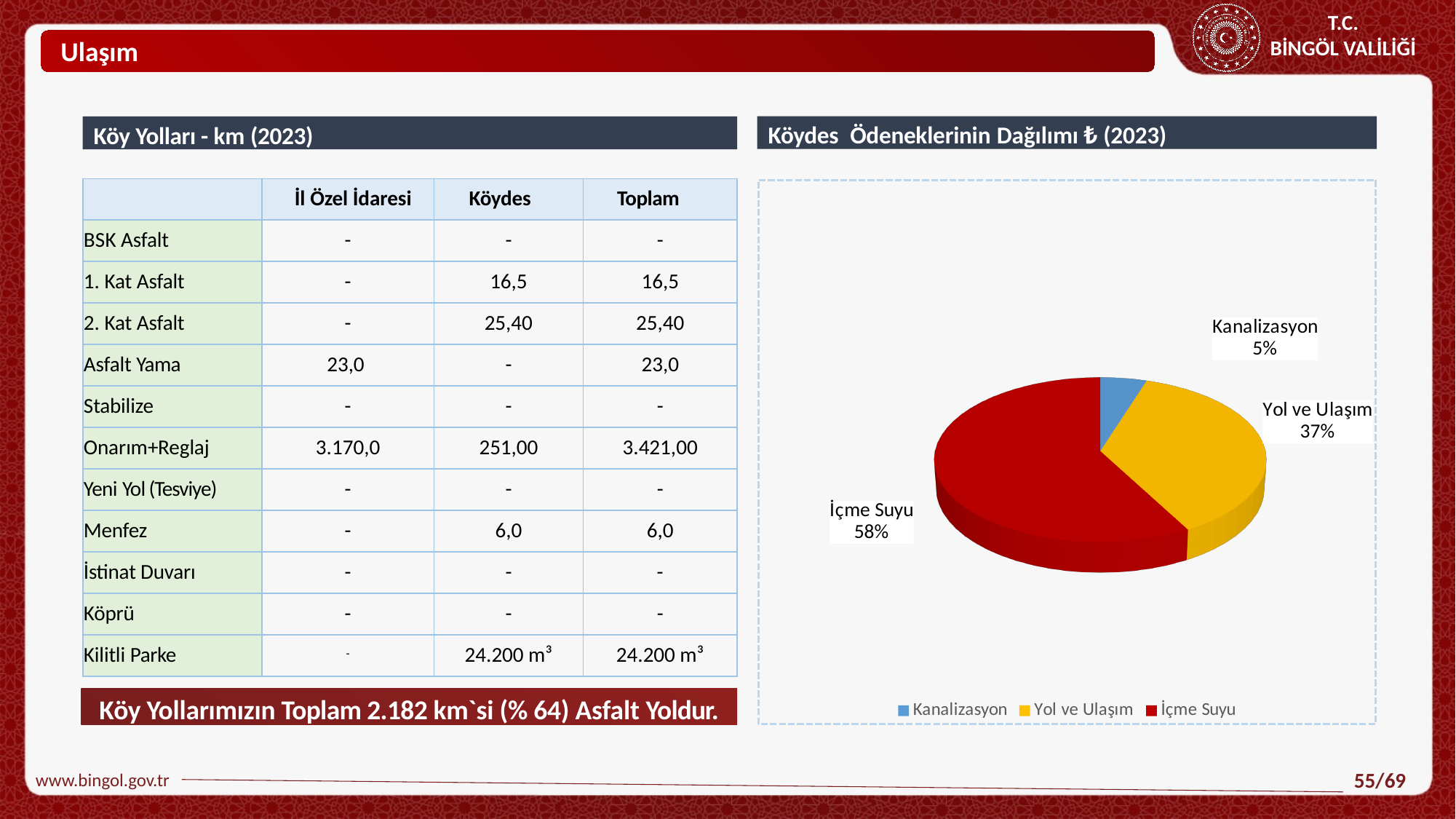
How many entries does the legend of the pie chart list? 3 What share of the pie does İçme Suyu have? 58% How many slices does the pie chart have? 3 What is the title of the pie chart? Köydes Ödeneklerinin Dağılımı ₺ (2023) What share of the pie does Yol ve Ulaşım have? 37% Which category has the largest slice of the pie? İçme Suyu What colour is the İçme Suyu slice in the pie chart? red What kind of chart is shown on the slide? pie chart What is the difference in percentage points between İçme Suyu and Yol ve Ulaşım? 21 What share of the pie does Kanalizasyon have? 5% Which is larger, the share for Yol ve Ulaşım or the share for Kanalizasyon? Yol ve Ulaşım Which category has the smallest slice of the pie? Kanalizasyon